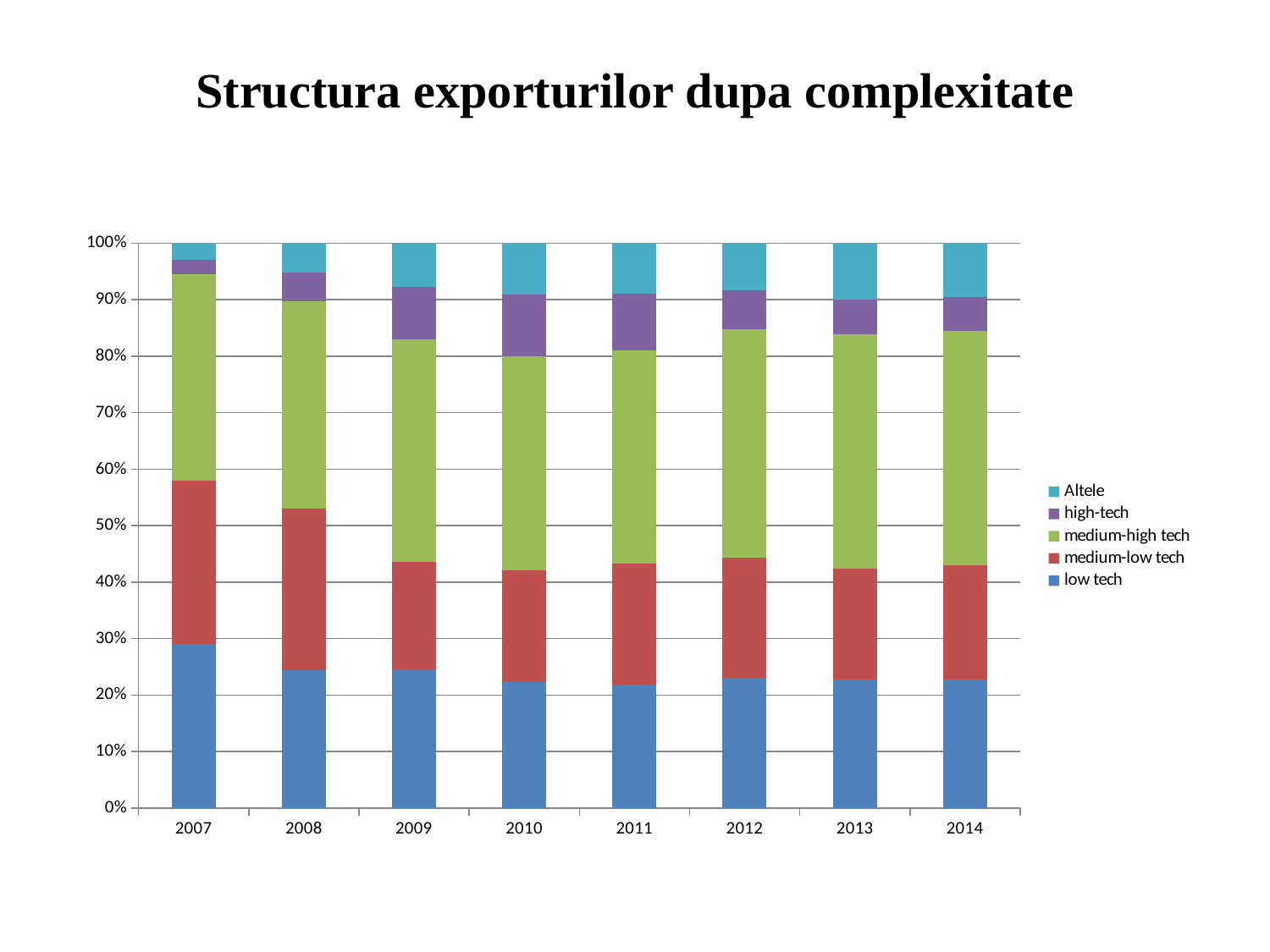
In which year is the Altele share the smallest? 2007 What is the title of the chart? Structura exporturilor dupa complexitate Which is larger, the Altele share in 2007 or in 2014? 2014 What kind of chart is shown on the slide? stacked bar chart Is the low tech value for 2007 greater or less than 20%? greater What is the total of the stacked bar for 2010? 100% Which series is shown in green in the legend? medium-high tech Is the low tech value for 2011 greater or less than 30%? less How many years are shown on the x axis of the chart? 8 In which year is the low tech share the highest? 2007 In which year is the high-tech share the smallest? 2007 How many series does the legend list? 5